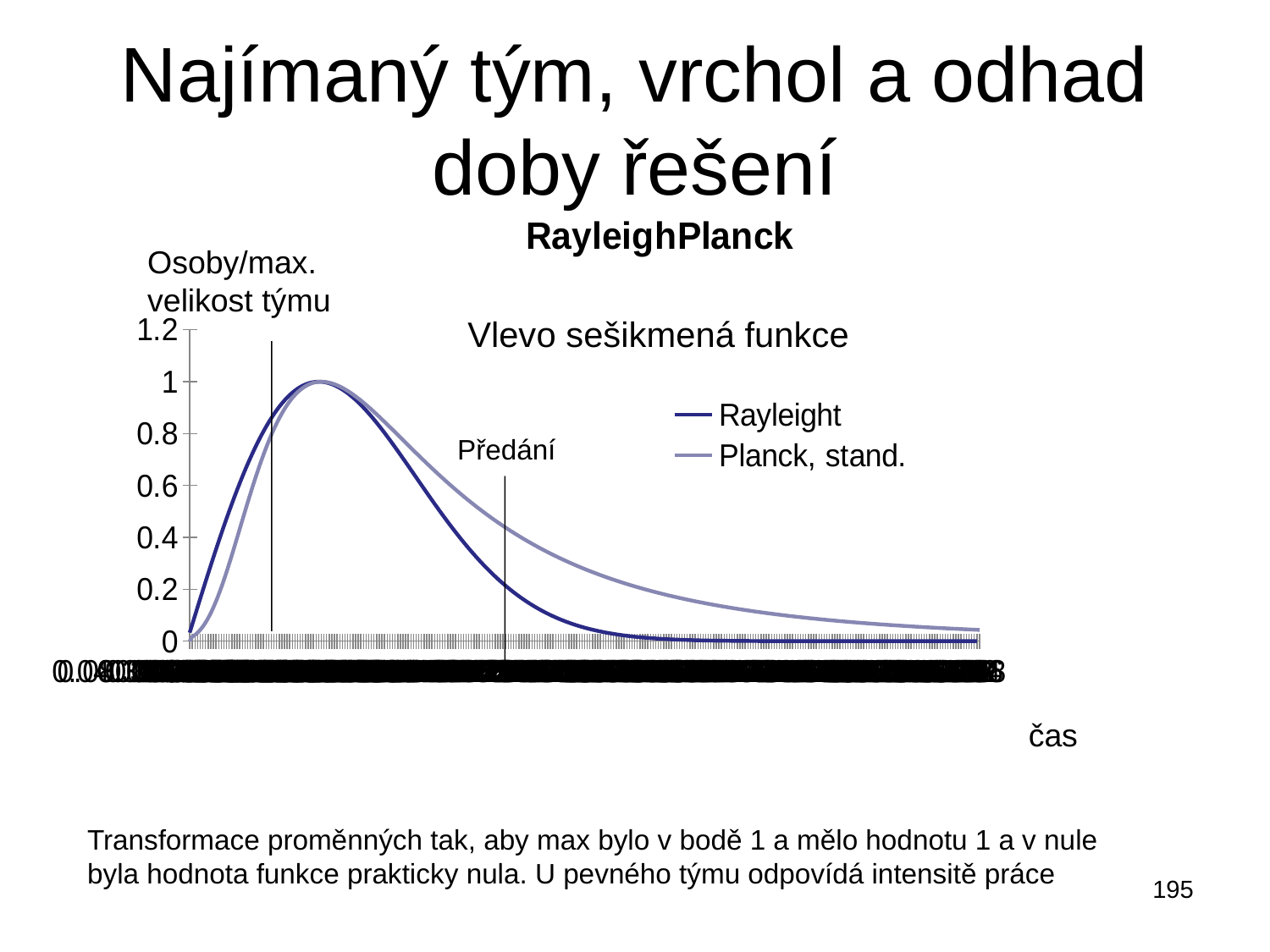
What is the maximum value reached by the Rayleight curve? 1 At the right end of the chart, which curve has the larger value, Rayleight or Planck, stand.? Planck, stand. Which curve falls to nearly 0 sooner after the peak, Rayleight or Planck, stand.? Rayleight How many series does the chart legend list? 2 What is the title of the chart? RayleighPlanck At the vertical line labelled Předání, is the value of the Rayleight curve greater or less than 0.4? less After reaching their peak, do the curves rise or fall as time increases along the x axis? fall At the vertical line labelled Předání, is the value of the Planck, stand. curve greater or less than 0.2? greater What kind of chart is shown on the slide? line chart What is the highest tick value shown on the vertical axis? 1.2 What is the maximum value reached by the Planck, stand. curve? 1 What are the two series named in the chart legend? Rayleight and Planck, stand.